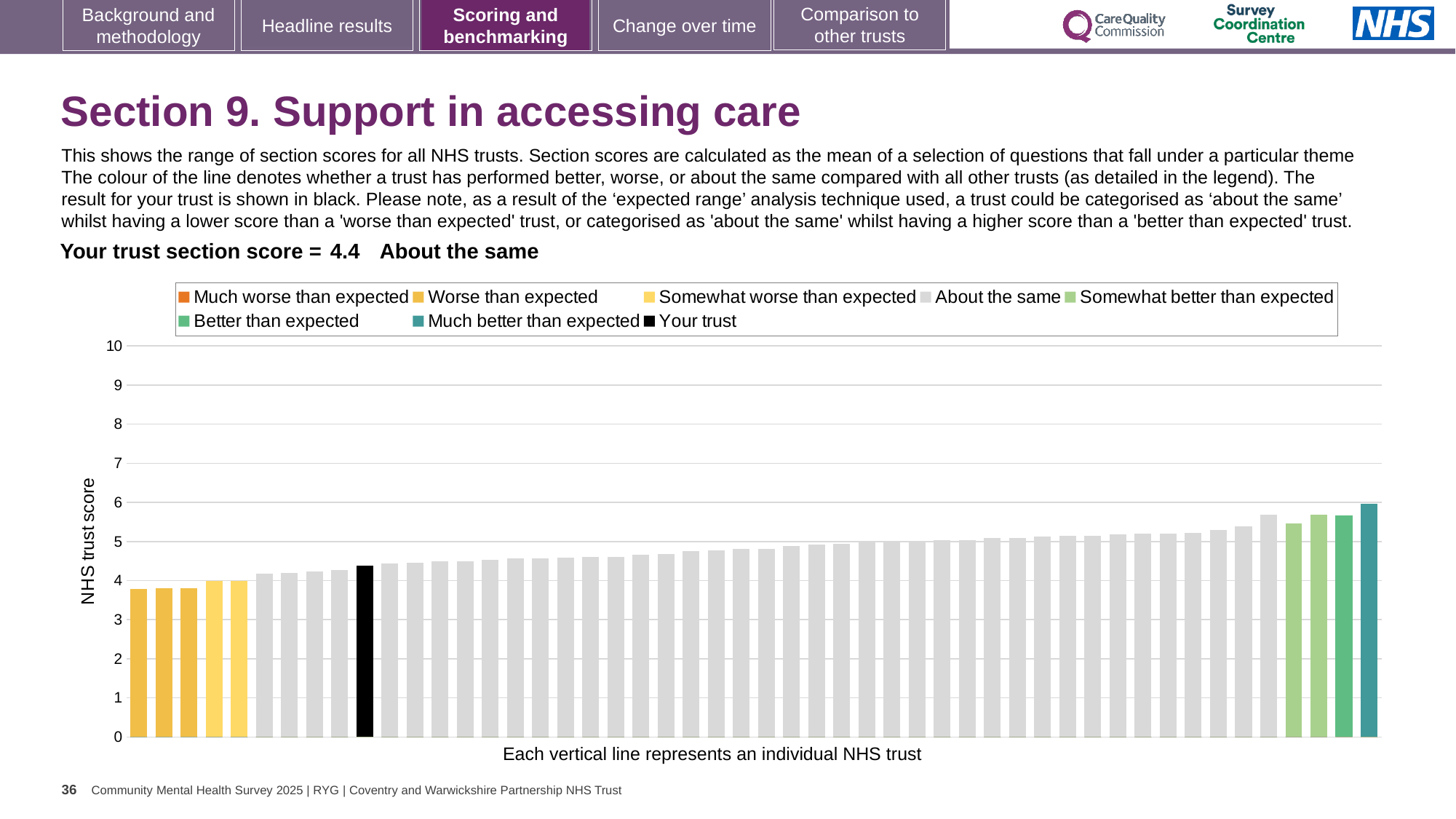
Do the bar values rise or fall from left to right along the x axis? rise Is the value of the highest bar in the chart greater or less than 5? greater How many bars are coloured as 'Much better than expected'? 1 Is the value for your trust (the black bar) greater or less than 4? greater Which category is your trust placed in for this section? About the same What kind of chart is shown on the slide? Bar chart How many bars are coloured as 'Better than expected'? 1 How many entries does the chart legend list? 8 Is the value of the lowest bar in the chart greater or less than 4? less What is the section score for your trust shown on the slide? 4.4 What colour is the bar representing your trust? Black What is the label of the y axis? NHS trust score